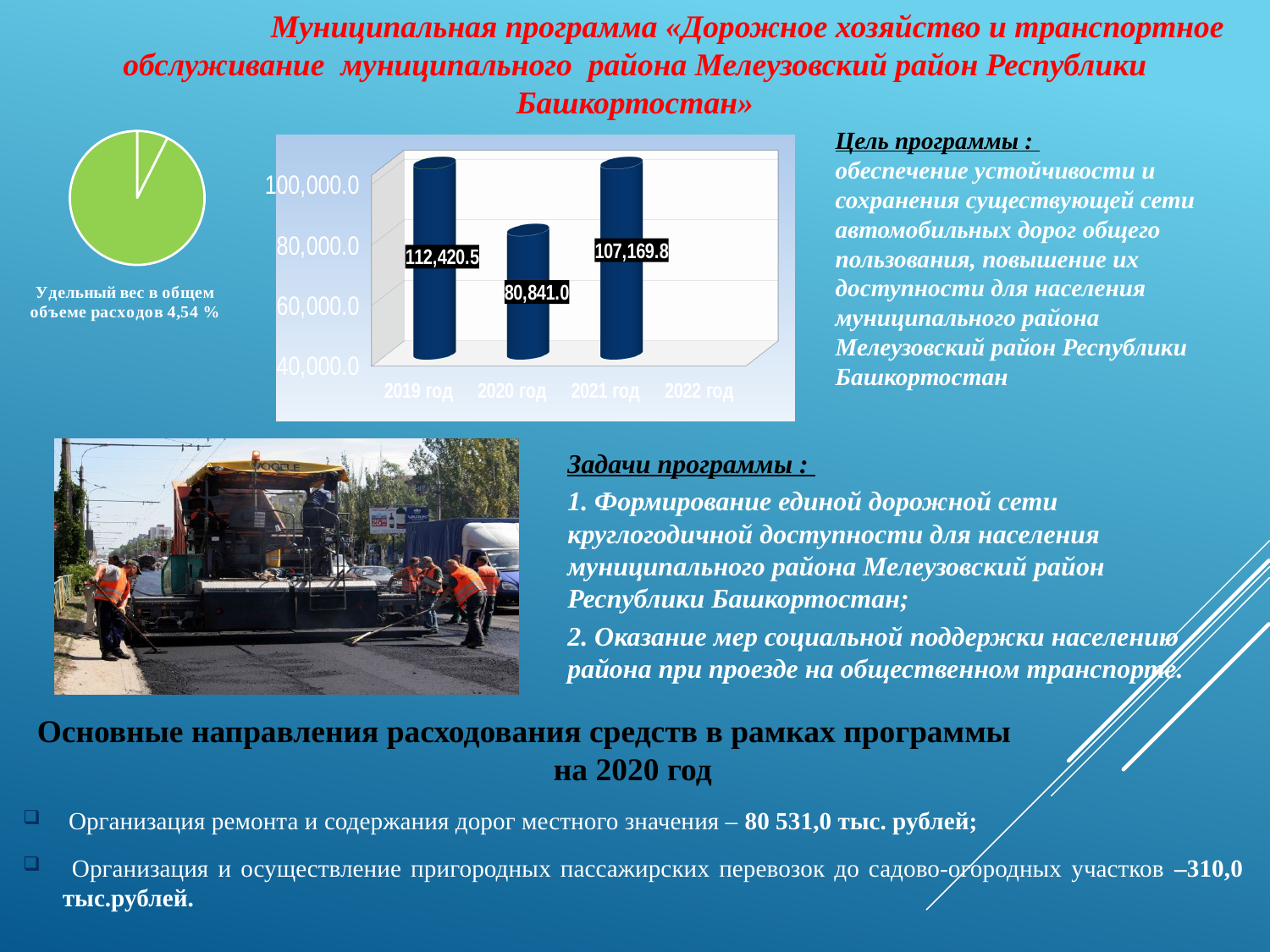
How many bars are plotted in the bar chart? 3 In the bar chart, what is the difference between the values for 2021 год and 2020 год? 26,328.8 In the bar chart, which year has the lowest value among the plotted bars? 2020 год In the bar chart, which year has the highest value? 2019 год In the bar chart, what is the value for 2019 год? 112,420.5 In the bar chart, what is the difference between the values for 2019 год and 2020 год? 31,579.5 In the bar chart, is the value for 2020 год greater or less than 100,000.0? less In the bar chart, what is the value for 2021 год? 107,169.8 In the bar chart, does the value rise or fall from 2019 год to 2020 год? fall In the bar chart, which is larger: the value for 2019 год or 2021 год? 2019 год What kind of chart is the large chart in the middle of the slide? bar chart In the bar chart, what is the value for 2020 год? 80,841.0